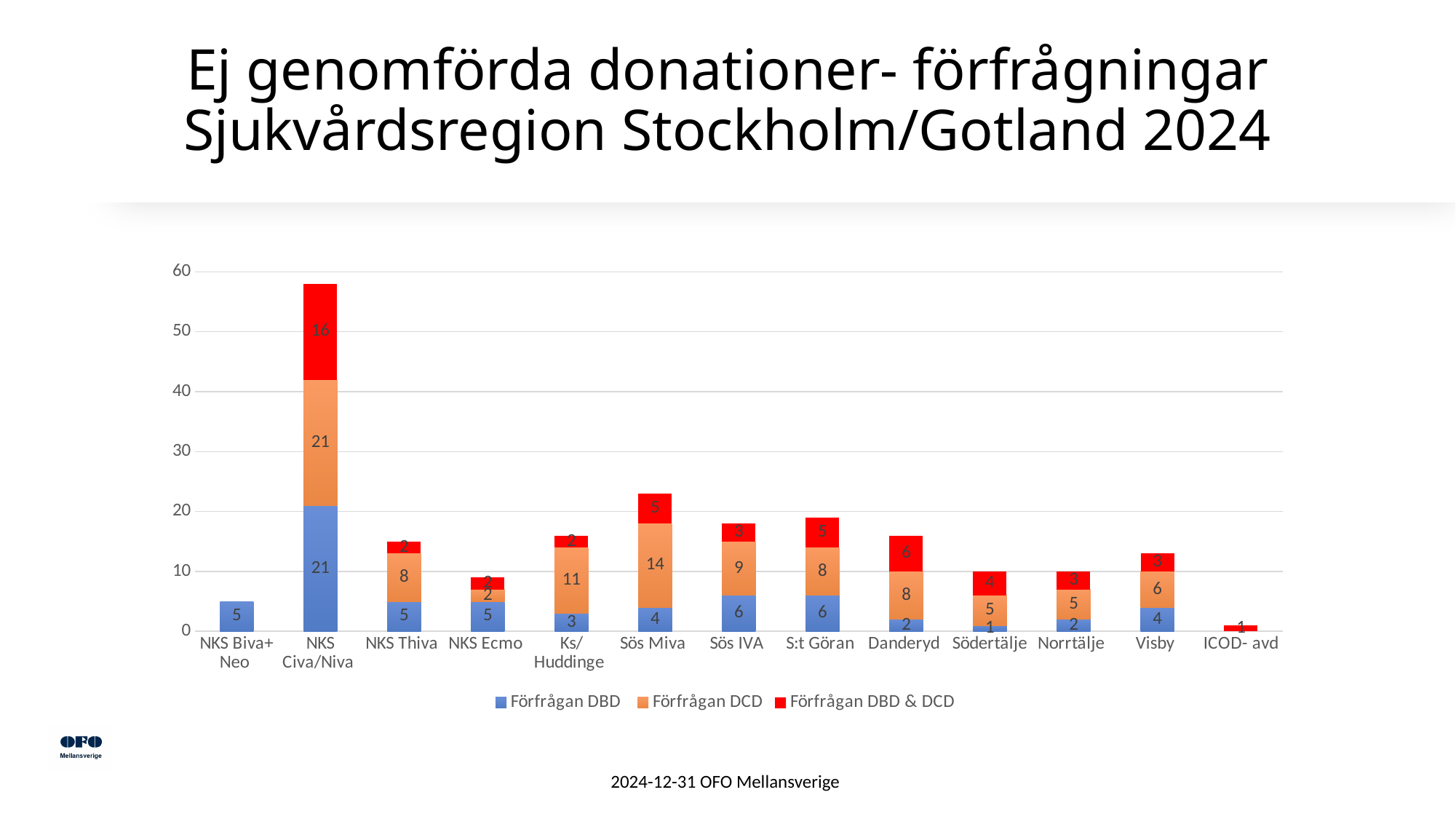
What is the Förfrågan DBD value for Södertälje? 1 What is the Förfrågan DCD value for Sös Miva? 14 What kind of chart is shown on the slide? Stacked bar chart Which series is shown in red in the legend? Förfrågan DBD & DCD How many series does the legend list? 3 Which category has the lowest total stacked bar? ICOD- avd Which category has the highest total stacked bar? NKS Civa/Niva What is the difference between the Förfrågan DCD values for Ks/Huddinge and NKS Thiva? 3 How many categories are shown on the x axis? 13 What is the Förfrågan DBD & DCD value for NKS Civa/Niva? 16 Which is larger, the Förfrågan DBD & DCD value for Danderyd or for Visby? Danderyd What is the total of the stacked bar for Sös IVA? 18